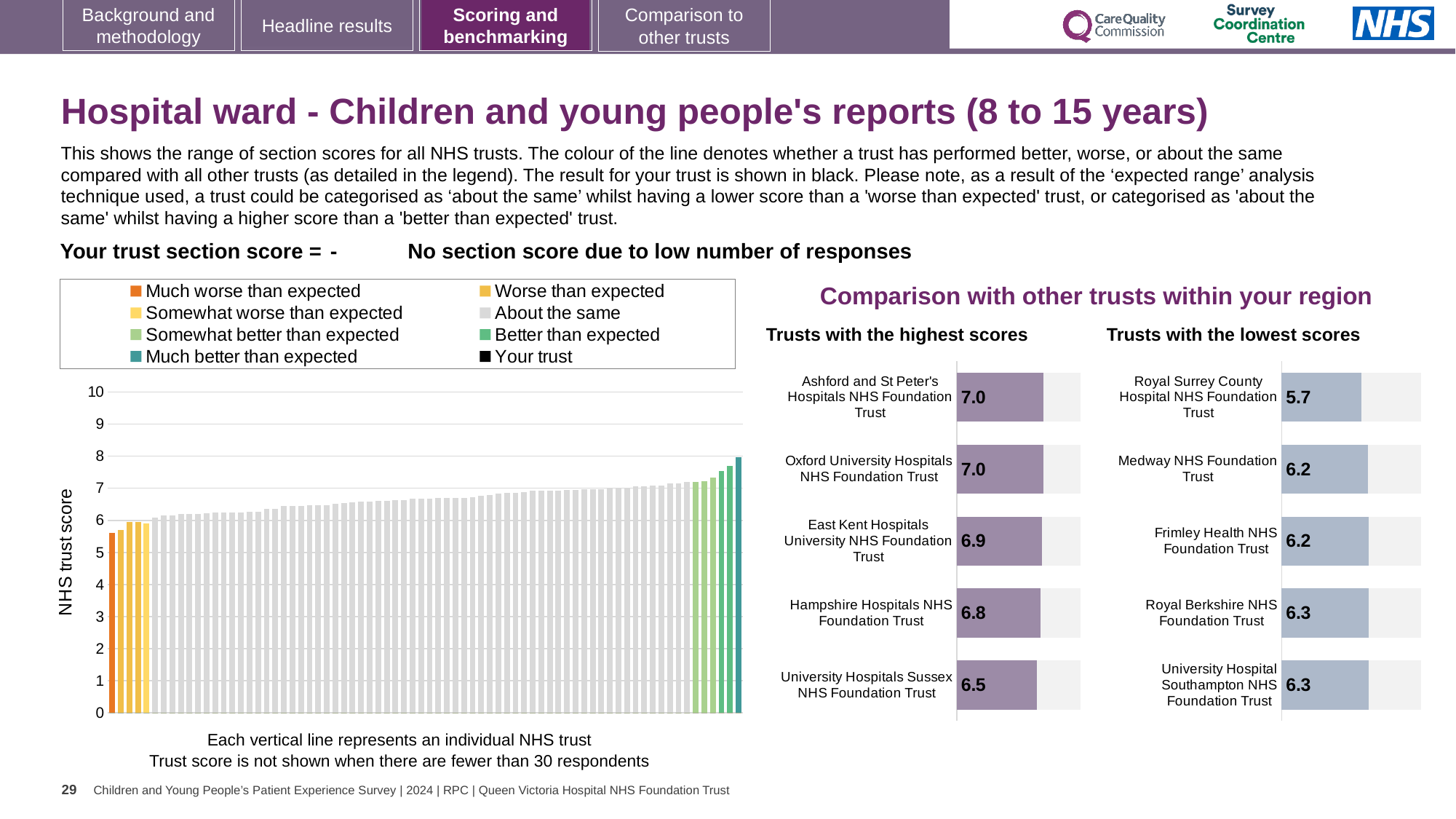
In the 'Trusts with the lowest scores' chart, what is the score for Royal Surrey County Hospital NHS Foundation Trust? 5.7 In the 'Trusts with the lowest scores' chart, which trust has the lowest score? Royal Surrey County Hospital NHS Foundation Trust In the 'Trusts with the highest scores' chart, what is the score for East Kent Hospitals University NHS Foundation Trust? 6.9 In the 'Trusts with the highest scores' chart, which trust has the lowest score shown? University Hospitals Sussex NHS Foundation Trust In the 'Trusts with the highest scores' chart, what is the difference between the scores of Ashford and St Peter's Hospitals NHS Foundation Trust and University Hospitals Sussex NHS Foundation Trust? 0.5 In the 'Trusts with the highest scores' chart, what is the score for University Hospitals Sussex NHS Foundation Trust? 6.5 In the 'Trusts with the lowest scores' chart, what is the score for Royal Berkshire NHS Foundation Trust? 6.3 In the main 'NHS trust score' chart on the left, do the bar values rise or fall from left to right? rise How many trusts are listed in the 'Trusts with the highest scores' chart? 5 How many entries does the legend of the main 'NHS trust score' chart on the left list? 8 In the 'Trusts with the lowest scores' chart, how much higher is University Hospital Southampton NHS Foundation Trust's score than Royal Surrey County Hospital NHS Foundation Trust's score? 0.6 In the 'Trusts with the highest scores' chart, which has the higher score: East Kent Hospitals University NHS Foundation Trust or Hampshire Hospitals NHS Foundation Trust? East Kent Hospitals University NHS Foundation Trust